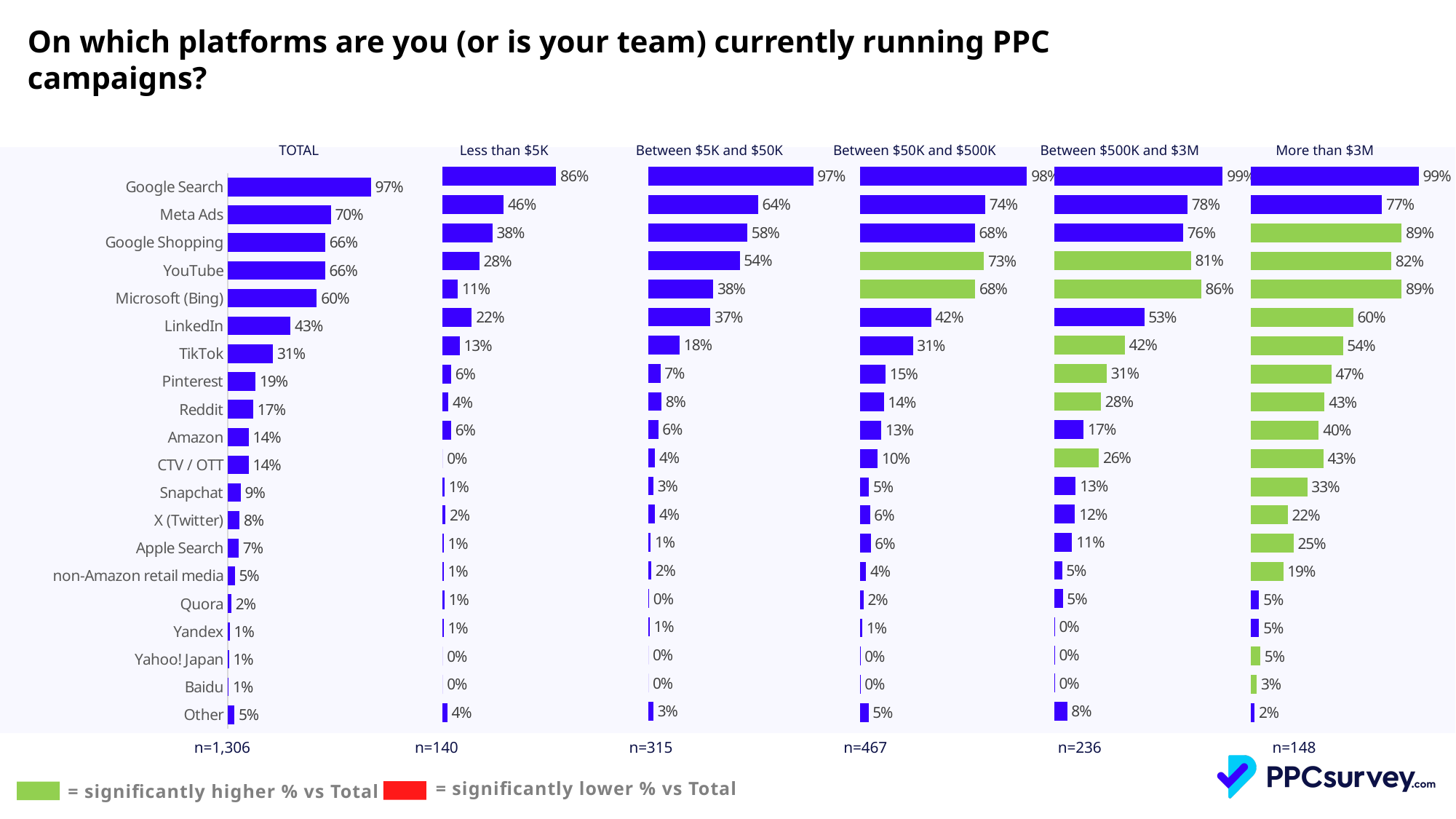
In the TOTAL chart, what percentage of respondents run PPC campaigns on Google Search? 97% In the Between $5K and $50K chart, what is the value for TikTok? 18% What kind of chart is used on this slide? Bar chart In the More than $3M chart, which platform has the lowest value? Other According to the legend, what does a green bar indicate? Significantly higher % vs Total In the Less than $5K chart, which platform has the highest value? Google Search In the Between $500K and $3M chart, what is the difference between the values for Microsoft (Bing) and LinkedIn? 33 percentage points In the Between $500K and $3M chart, which is larger: the value for YouTube or the value for Meta Ads? YouTube What is the sample size (n) shown for the Between $50K and $500K chart? n=467 In the TOTAL chart, what is the difference between the values for Meta Ads and Google Shopping? 4 percentage points How many platforms are listed in each chart? 20 In the More than $3M chart, what is the value for Microsoft (Bing)? 89%